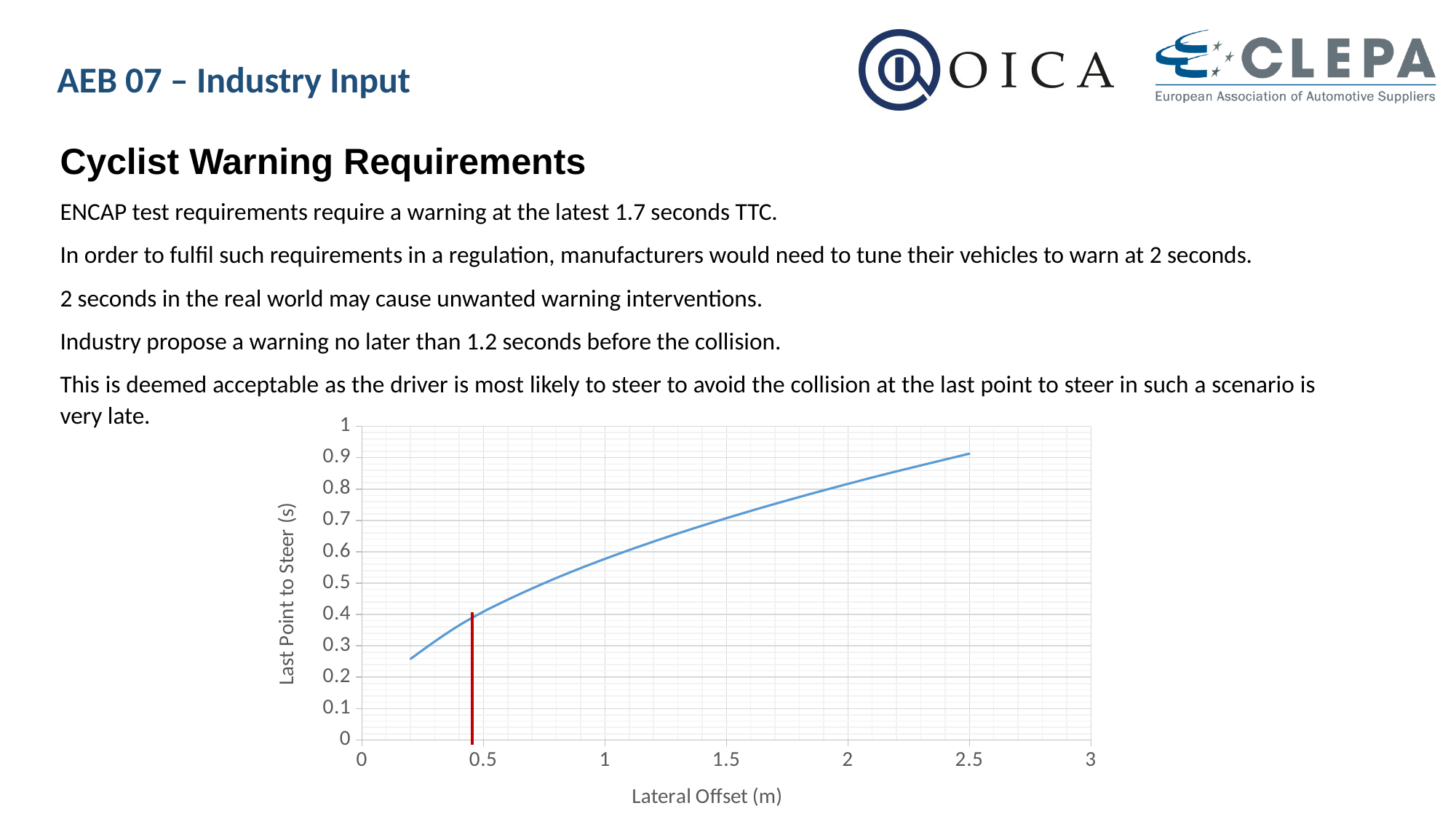
Is the Last Point to Steer at a Lateral Offset of 1 m greater or less than 0.5 s? greater Is the Last Point to Steer at a Lateral Offset of 2.5 m greater or less than 0.8 s? greater Is the Last Point to Steer at a Lateral Offset of 1 m greater or less than 0.7 s? less Which has the larger Last Point to Steer: a Lateral Offset of 1 m or 2 m? 2 m What is the title of the y axis of the chart? Last Point to Steer (s) What kind of chart is shown on the slide? line chart What is the title of the x axis of the chart? Lateral Offset (m) Does the Last Point to Steer rise or fall as Lateral Offset increases? rise